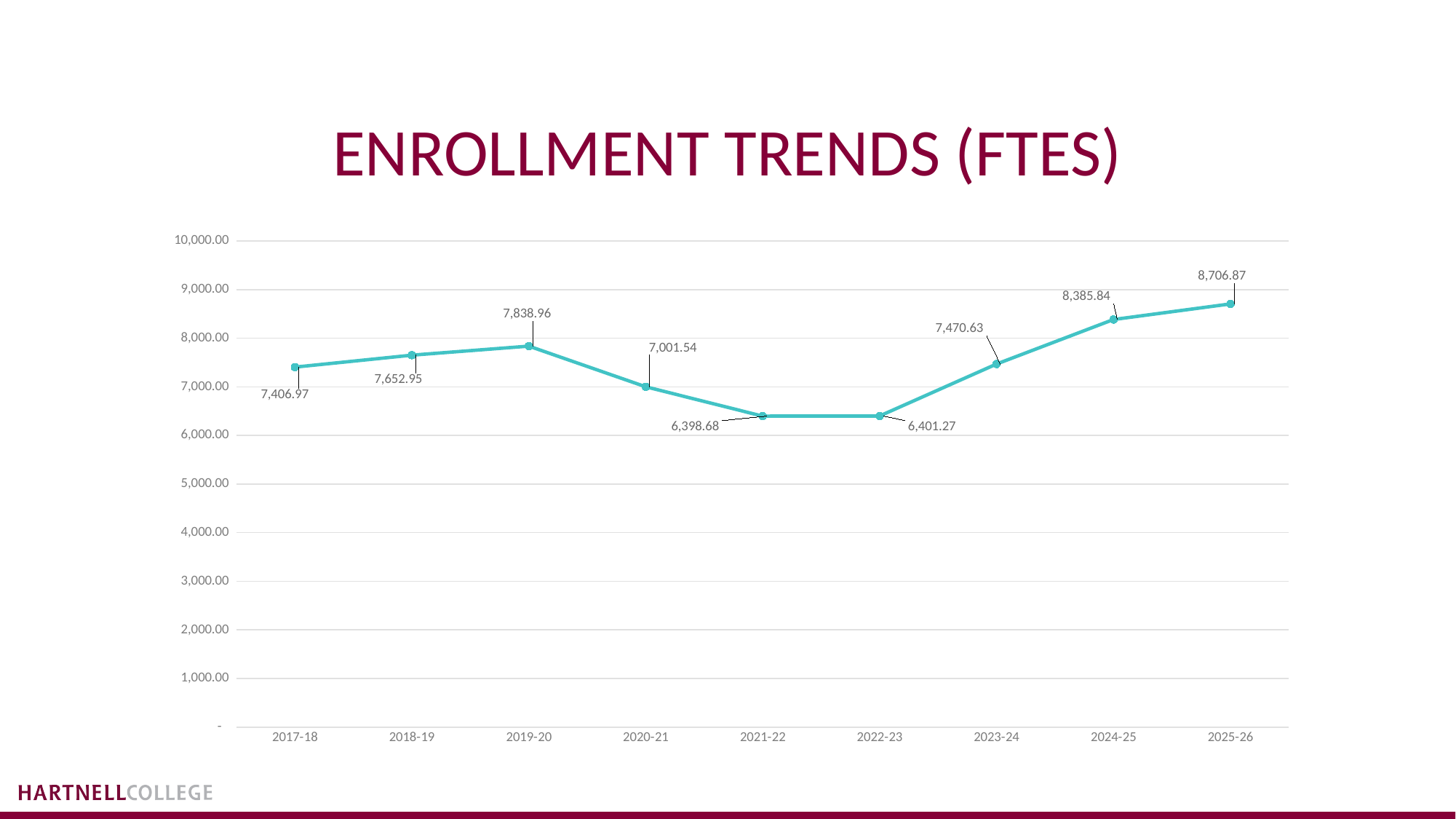
What is the FTES value for 2024-25? 8,385.84 Do the FTES values rise or fall from 2022-23 to 2025-26? Rise Which academic year has the lowest FTES value? 2021-22 What is the FTES value for 2022-23? 6,401.27 Is the FTES value for 2023-24 greater or less than 7,000.00? greater Which is larger, the FTES value for 2018-19 or for 2020-21? 2018-19 What is the difference between the FTES values for 2019-20 and 2017-18? 431.99 What is the FTES value for 2019-20? 7,838.96 What type of chart is shown on the slide? Line chart What is the difference between the FTES values for 2025-26 and 2024-25? 321.03 How many academic years are plotted on the chart? 9 Which academic year has the highest FTES value? 2025-26